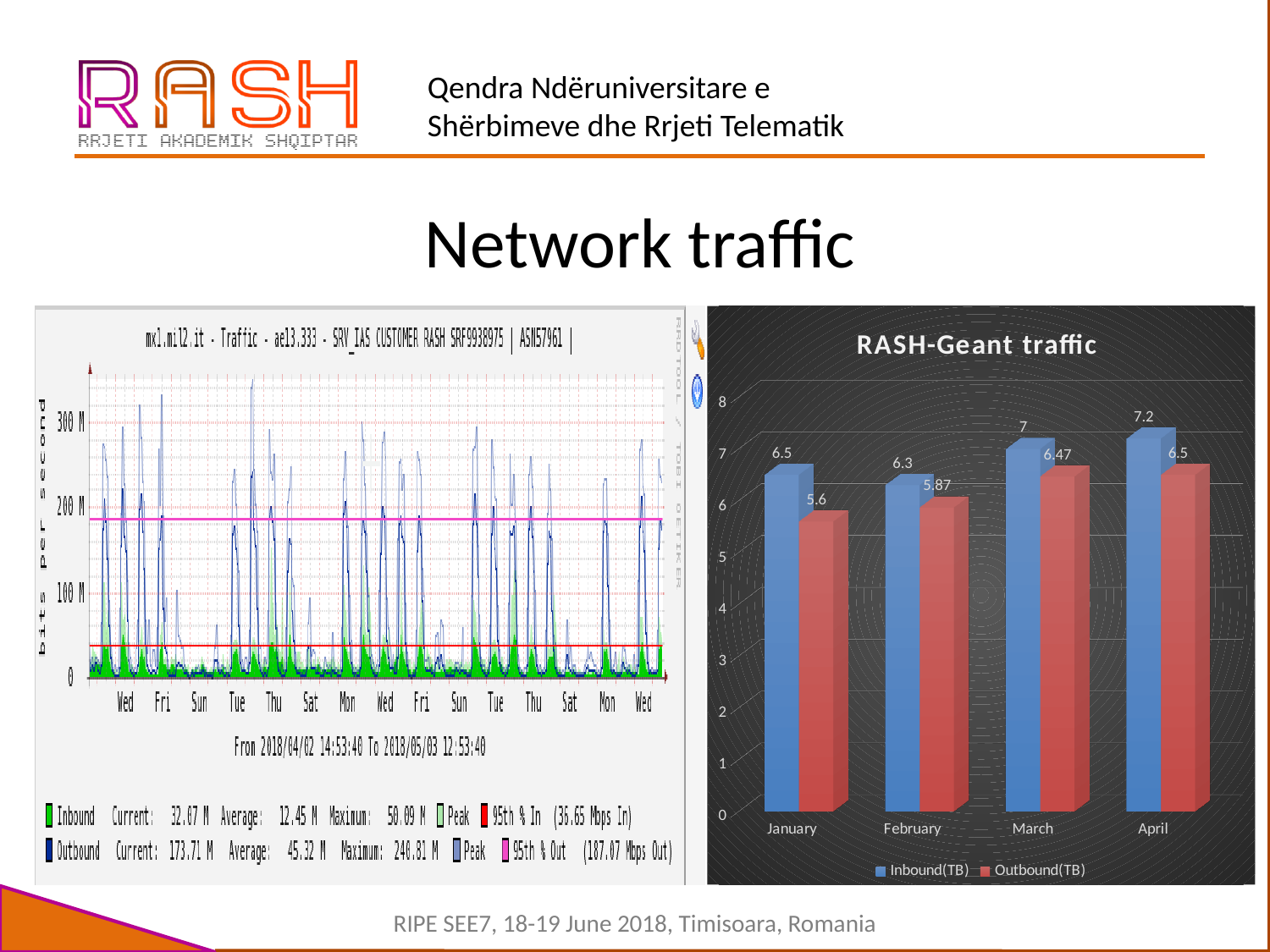
How many series does the legend of the RASH-Geant traffic chart list? 2 In the RASH-Geant traffic chart, does the Outbound(TB) value rise or fall from January to April? Rise How many months are shown on the x axis of the RASH-Geant traffic chart? 4 In the RASH-Geant traffic chart, what is the Inbound(TB) value for January? 6.5 What kind of chart is the RASH-Geant traffic chart on the right of the slide? Bar chart In the RASH-Geant traffic chart, what is the Outbound(TB) value for March? 6.47 In the RASH-Geant traffic chart, which is larger: the Inbound(TB) value for March or the Inbound(TB) value for February? March In the left-hand traffic graph, what is the Maximum value listed for Outbound? 240.81 M In the RASH-Geant traffic chart, which month has the highest Inbound(TB) value? April In the RASH-Geant traffic chart, what is the difference between the Inbound(TB) and Outbound(TB) values for April? 0.7 In the RASH-Geant traffic chart, which month has the lowest Outbound(TB) value? January In the RASH-Geant traffic chart, what is the Outbound(TB) value for February? 5.87